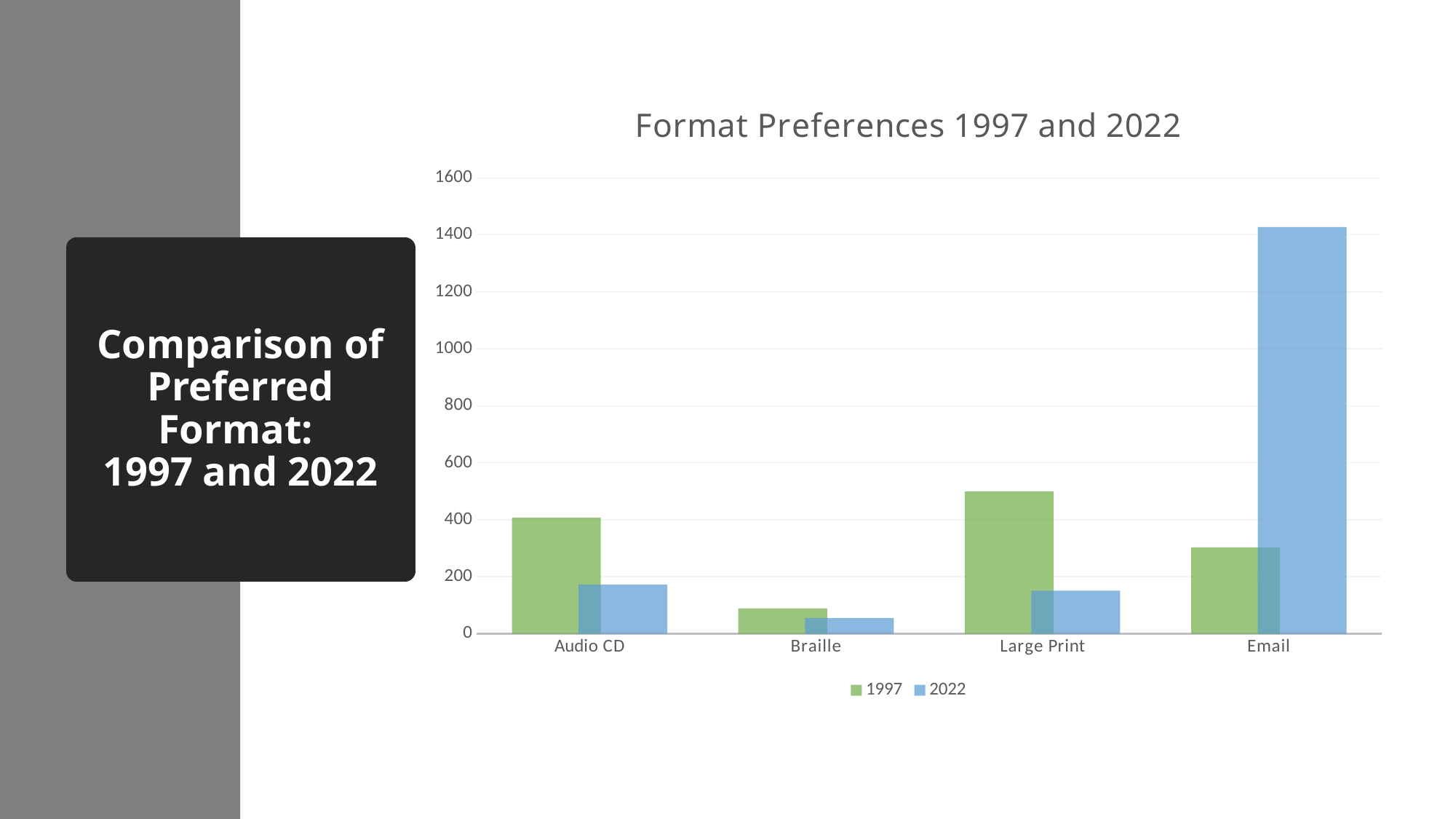
What type of chart is shown on the slide? bar chart What is the title of the chart? Format Preferences 1997 and 2022 Is the 1997 value for Braille greater or less than 200? less Which category has the tallest bar in the chart? Email Which category has the highest 1997 value? Large Print Is the 1997 value for Email greater or less than 400? less For Email, which series has the larger value, 1997 or 2022? 2022 Is the 2022 value for Email greater or less than 1200? greater For Audio CD, which series has the larger value, 1997 or 2022? 1997 How many series does the chart legend list? 2 How many format categories are shown on the x axis? 4 Which category has the lowest 2022 value? Braille